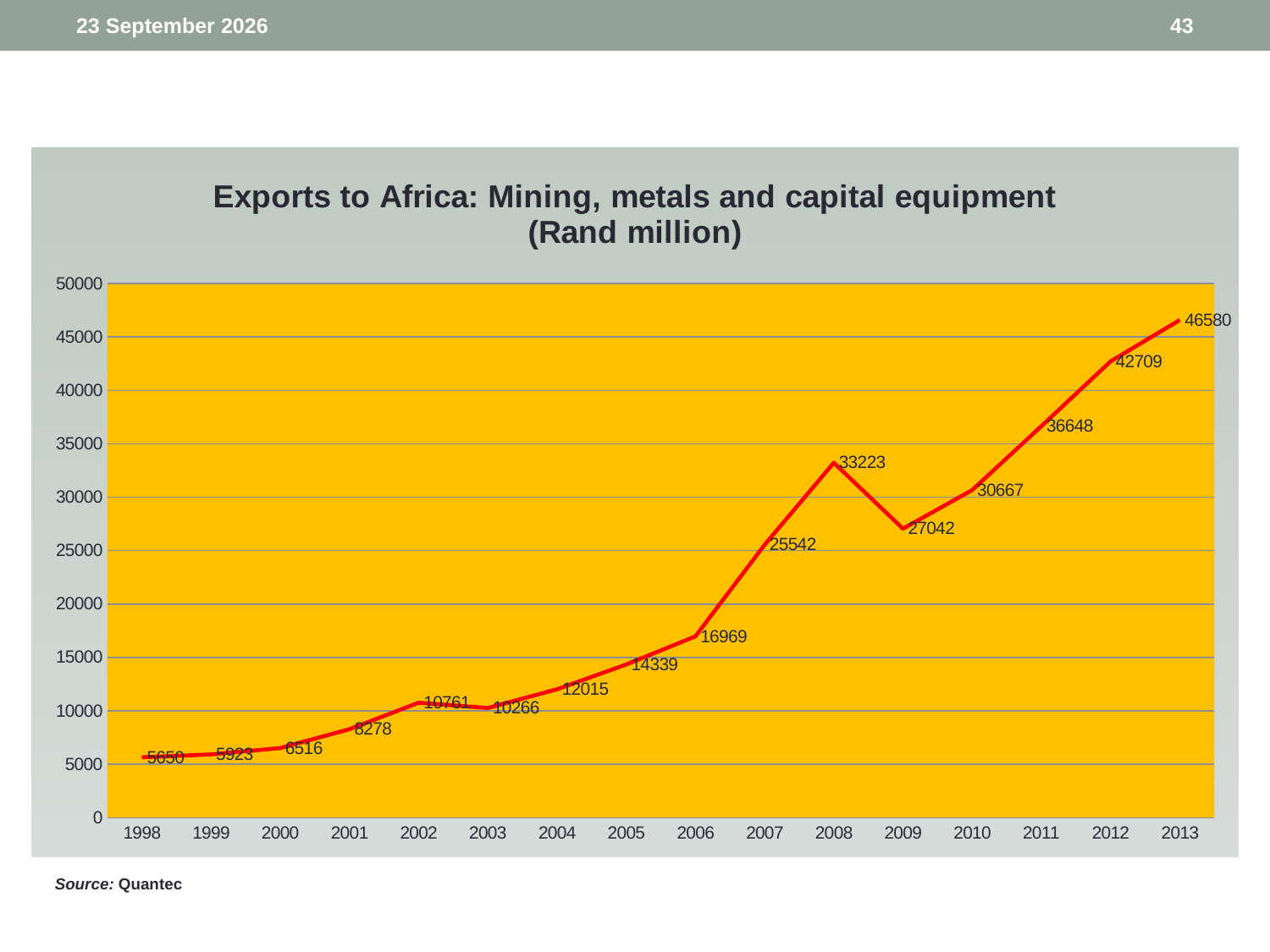
What kind of chart is shown? line chart Which year has the highest value? 2013 What is the difference between the values for 2008 and 2009? 6181 What is the value for 2008? 33223 What is the value for 1998? 5650 What is the difference between the values for 2013 and 2012? 3871 How many years are plotted on the x axis? 16 Which year has the lowest value? 1998 What is the title of the chart? Exports to Africa: Mining, metals and capital equipment (Rand million) Is the value for 2010 greater or less than 30000? greater What is the value for 2003? 10266 Which is larger, the value for 2002 or the value for 2003? 2002